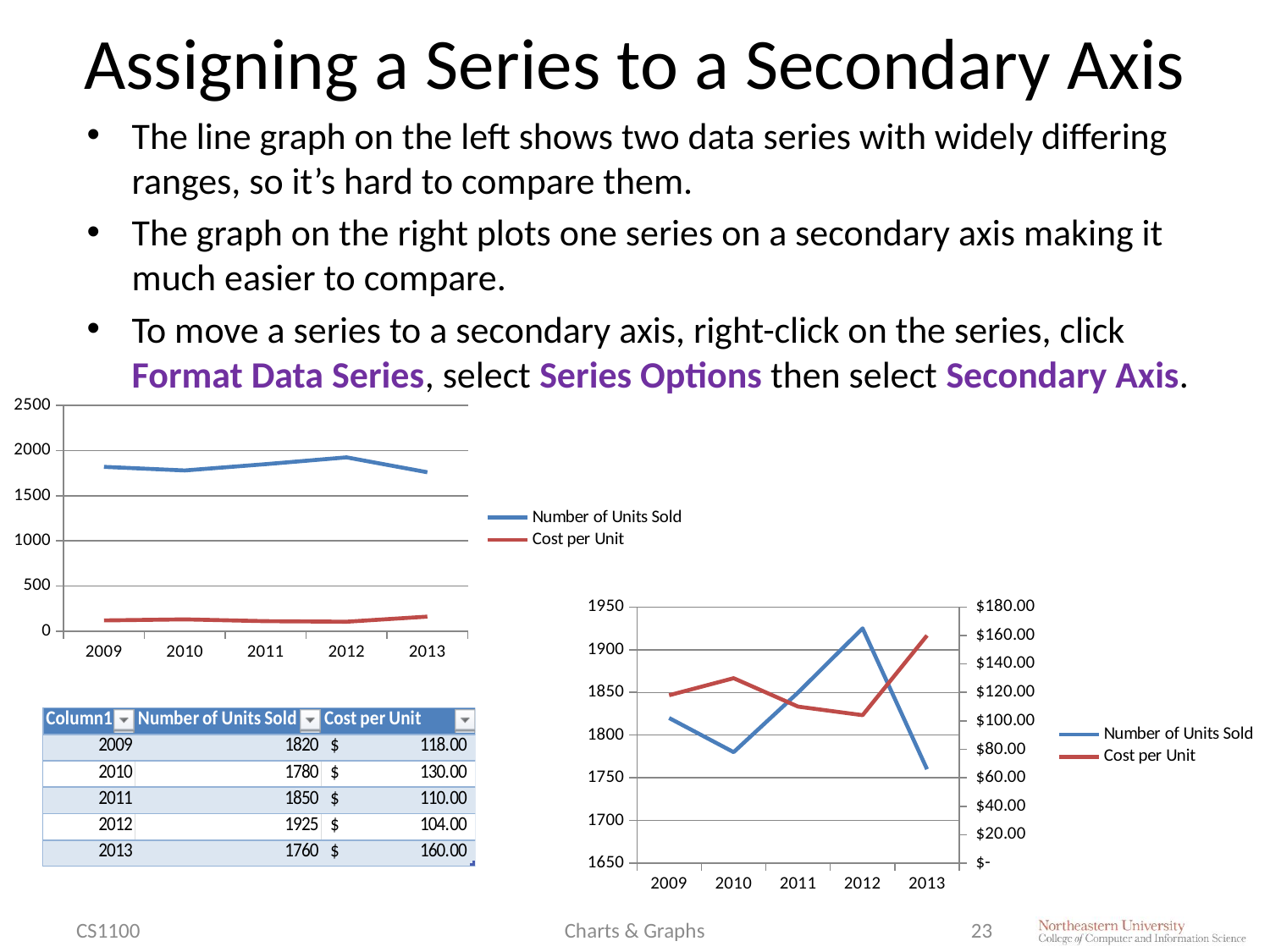
How many series does the legend of the chart on the right list? 2 In the chart on the left, what colour is the Cost per Unit line? red In the chart on the right, is the Cost per Unit for 2013 greater or less than $140.00? greater In the chart on the right, which year has the lowest Cost per Unit? 2012 In the chart on the right, which year has the highest Cost per Unit? 2013 In the chart on the right, which year has the lowest Number of Units Sold? 2013 In the chart on the right, is the Number of Units Sold for 2012 greater or less than 1900? greater In the chart on the right, which year has the highest Number of Units Sold? 2012 How many years are plotted along the x axis of the chart on the right? 5 In the chart on the right, which year has the larger Number of Units Sold, 2010 or 2011? 2011 In the chart on the right, does the Cost per Unit rise or fall from 2012 to 2013? rise What kind of chart is the chart on the left of the slide? line chart